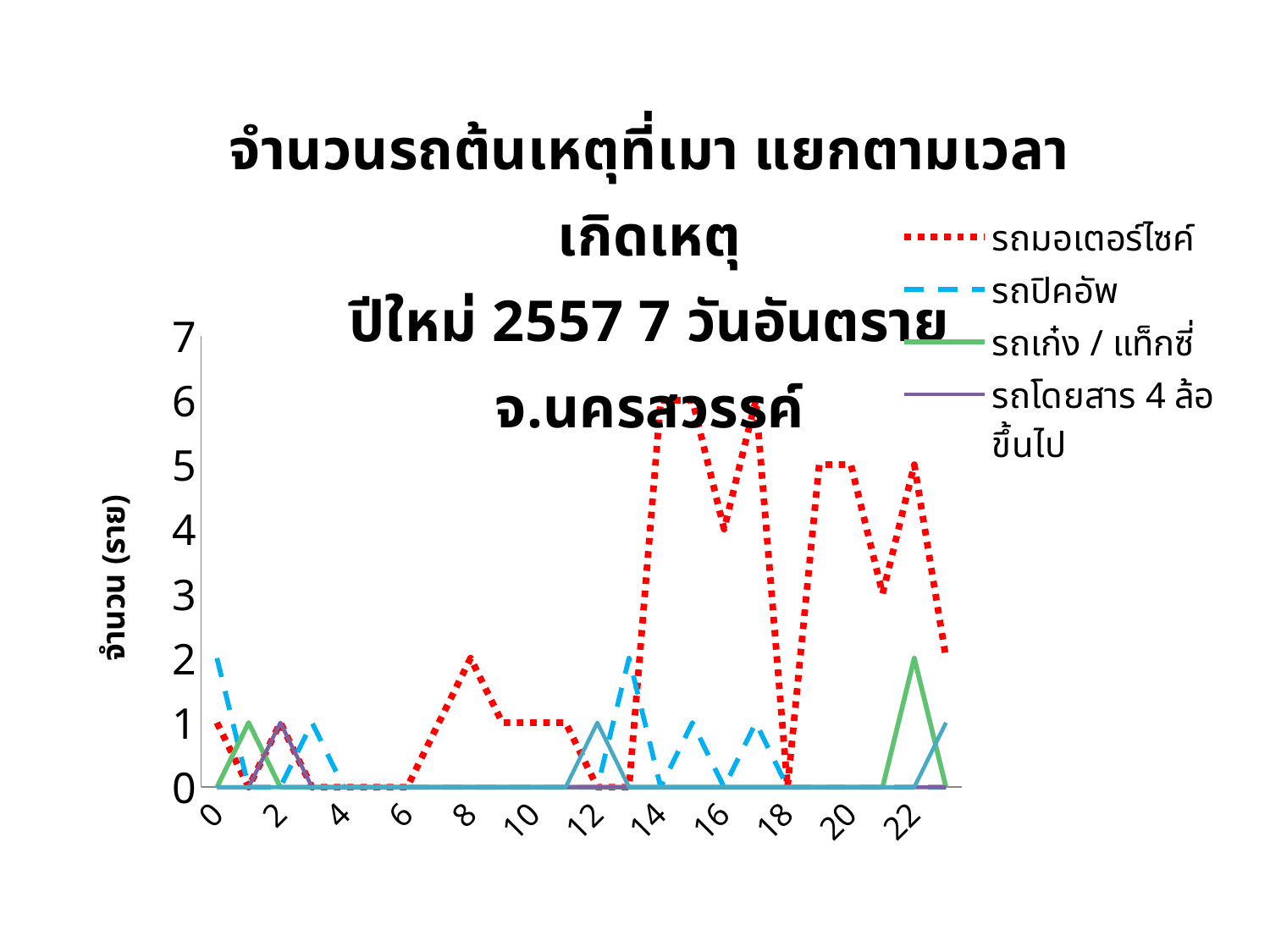
Is the value for รถมอเตอร์ไซค์ at hour 14 greater or less than 5? greater What is the value for รถมอเตอร์ไซค์ at hour 21? 3 Which series reaches the highest value on the chart? รถมอเตอร์ไซค์ What is the value for รถมอเตอร์ไซค์ at hour 16? 4 What is the difference between รถมอเตอร์ไซค์ at hour 16 and at hour 21? 1 How many series does the legend list? 4 What is the label of the vertical axis? จำนวน (ราย) Which is larger at hour 22: รถมอเตอร์ไซค์ or รถเก๋ง / แท็กซี่? รถมอเตอร์ไซค์ What is the value for รถมอเตอร์ไซค์ at hour 8? 2 What is the value for รถปิคอัพ at hour 0? 2 What kind of chart is shown on the slide? line chart What is the value for รถเก๋ง / แท็กซี่ at hour 22? 2